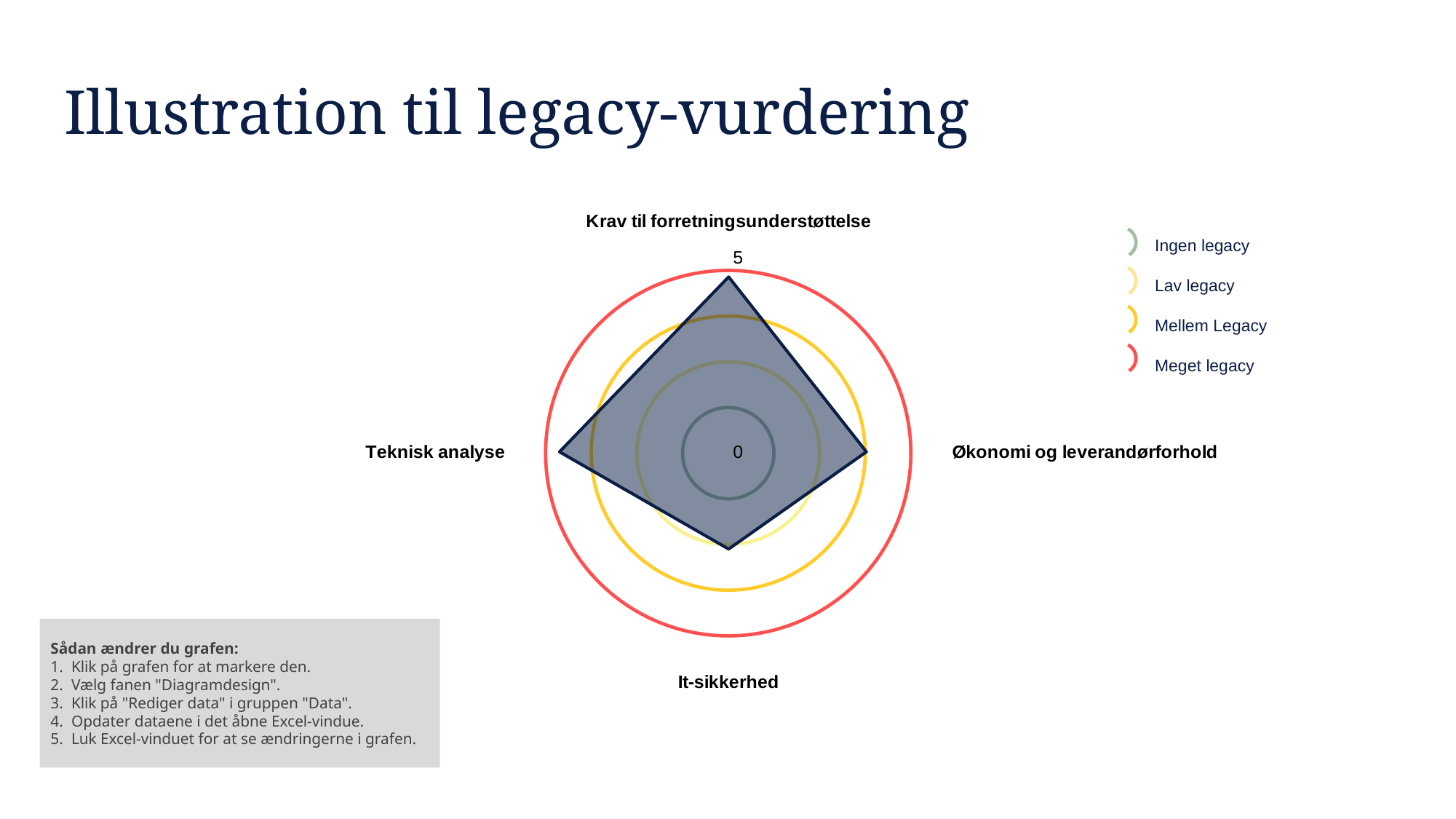
How many entries does the chart legend list? 4 Which is larger, the value for Teknisk analyse or the value for It-sikkerhed? Teknisk analyse Which category has the highest value in the radar chart? Krav til forretningsunderstøttelse What is the maximum value shown on the radar chart's axis scale? 5 Is the value for Økonomi og leverandørforhold greater or less than 5? less Which is larger, the value for Krav til forretningsunderstøttelse or the value for Økonomi og leverandørforhold? Krav til forretningsunderstøttelse Which category has the lowest value in the radar chart? It-sikkerhed Is the value for It-sikkerhed greater or less than 5? less Which legend entry is shown in red? Meget legacy How many categories (axes) does the radar chart have? 4 What kind of chart is shown on the slide? Radar chart